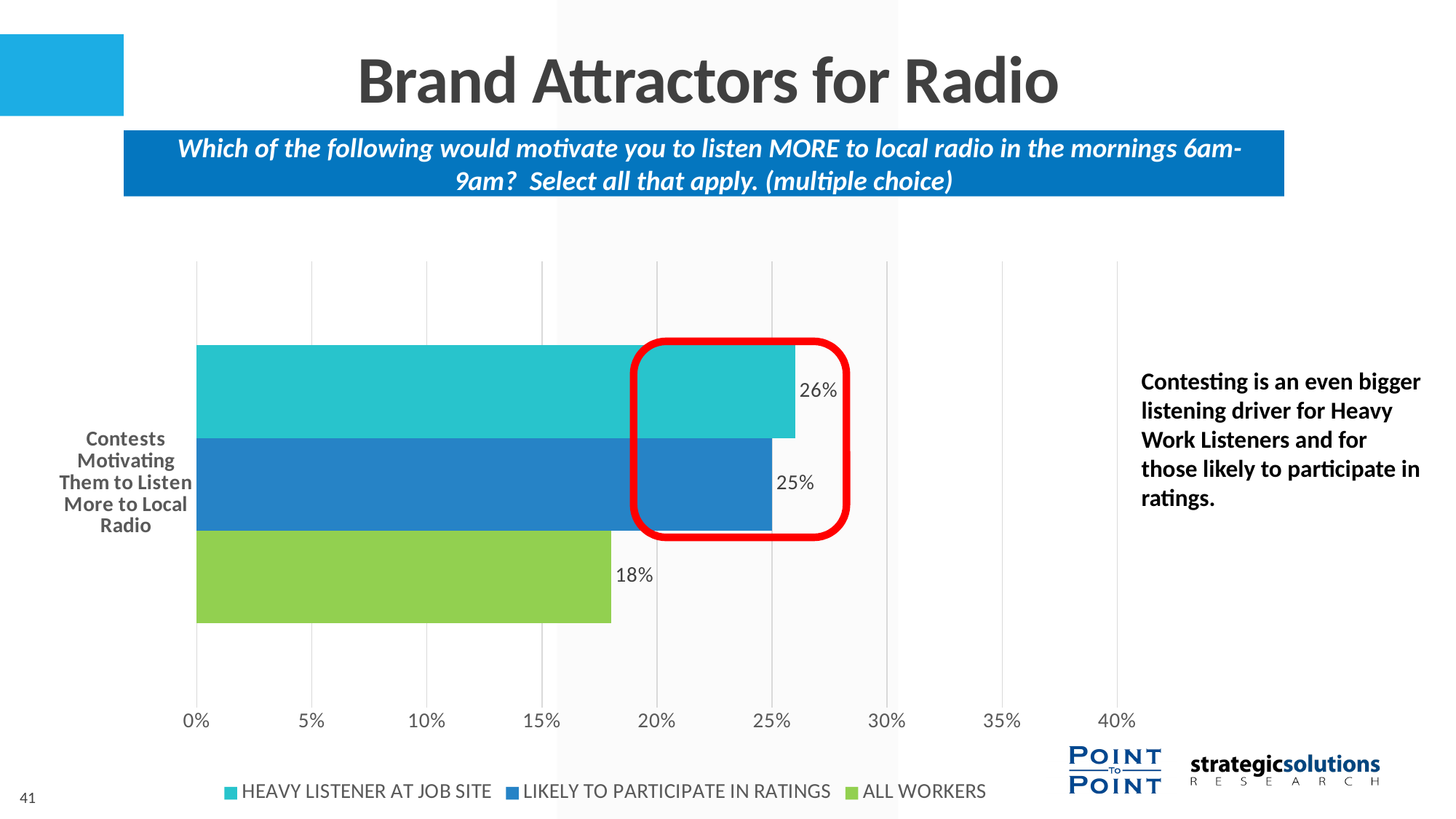
How many series does the legend list? 3 What is the value for Likely to Participate in Ratings? 25% What kind of chart is shown on the slide? bar chart What is the category label shown on the chart? Contests Motivating Them to Listen More to Local Radio Which series has the highest value? Heavy Listener at Job Site Which series has the lowest value? All Workers What is the difference between the Likely to Participate in Ratings value and the All Workers value? 7% What is the value for All Workers? 18% What is the difference between the Heavy Listener at Job Site value and the All Workers value? 8% Is the value for All Workers greater or less than 20%? less Which is larger, the value for Likely to Participate in Ratings or the value for All Workers? Likely to Participate in Ratings What is the value for Heavy Listener at Job Site? 26%